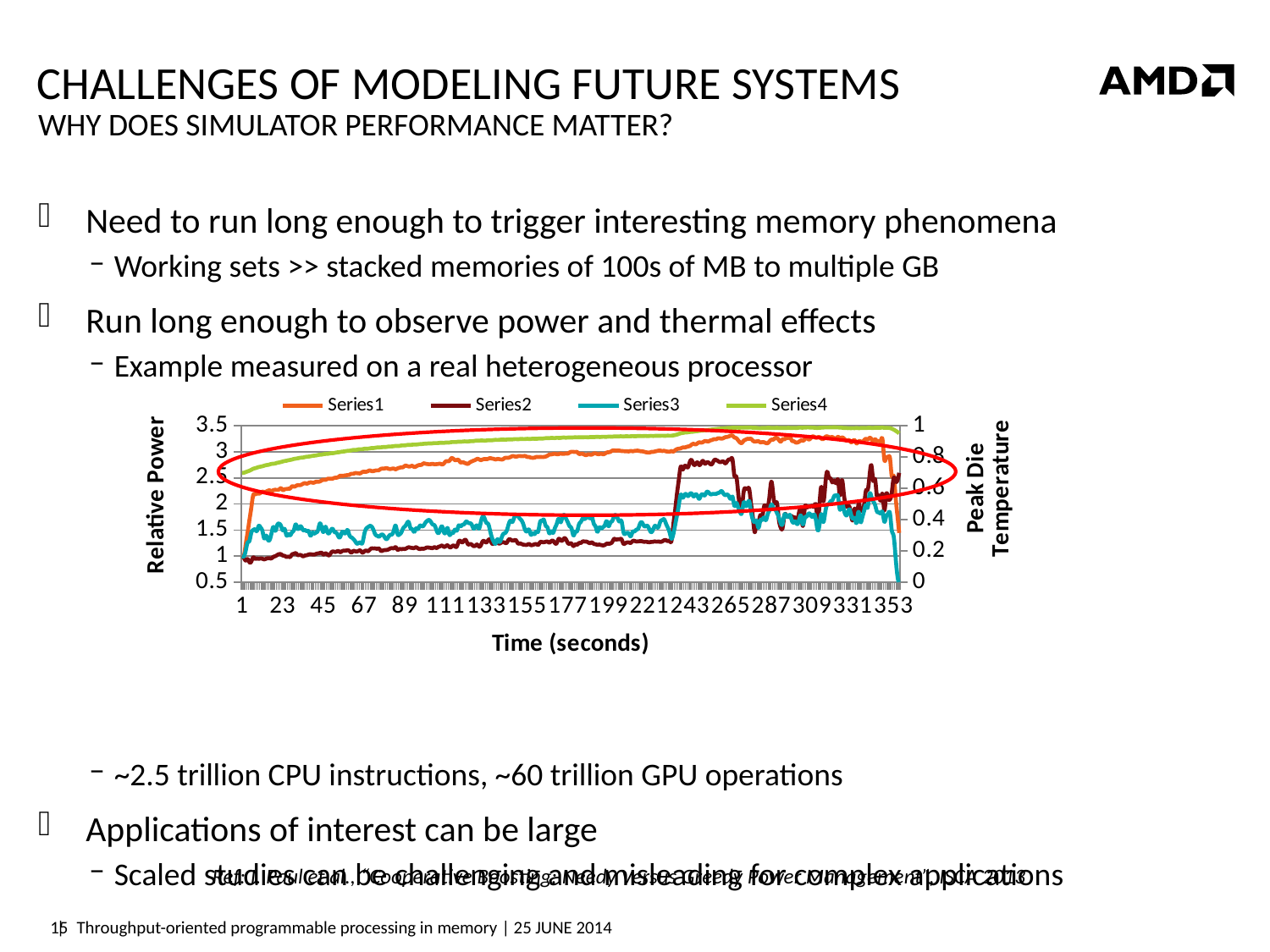
What is the last label shown on the chart's x axis? 353 What is the lowest value shown on the chart's left vertical axis? 0.5 Which series in the legend is listed first? Series1 What is the highest value shown on the chart's right vertical axis? 1 How many series does the chart's legend list? 4 What kind of chart is shown on the slide? Line chart Does Series4 generally rise or fall as time increases along the x axis? Rise What is the title of the chart's left vertical axis? Relative Power What is the highest value shown on the chart's left vertical axis? 3.5 What is the title of the chart's x axis? Time (seconds)